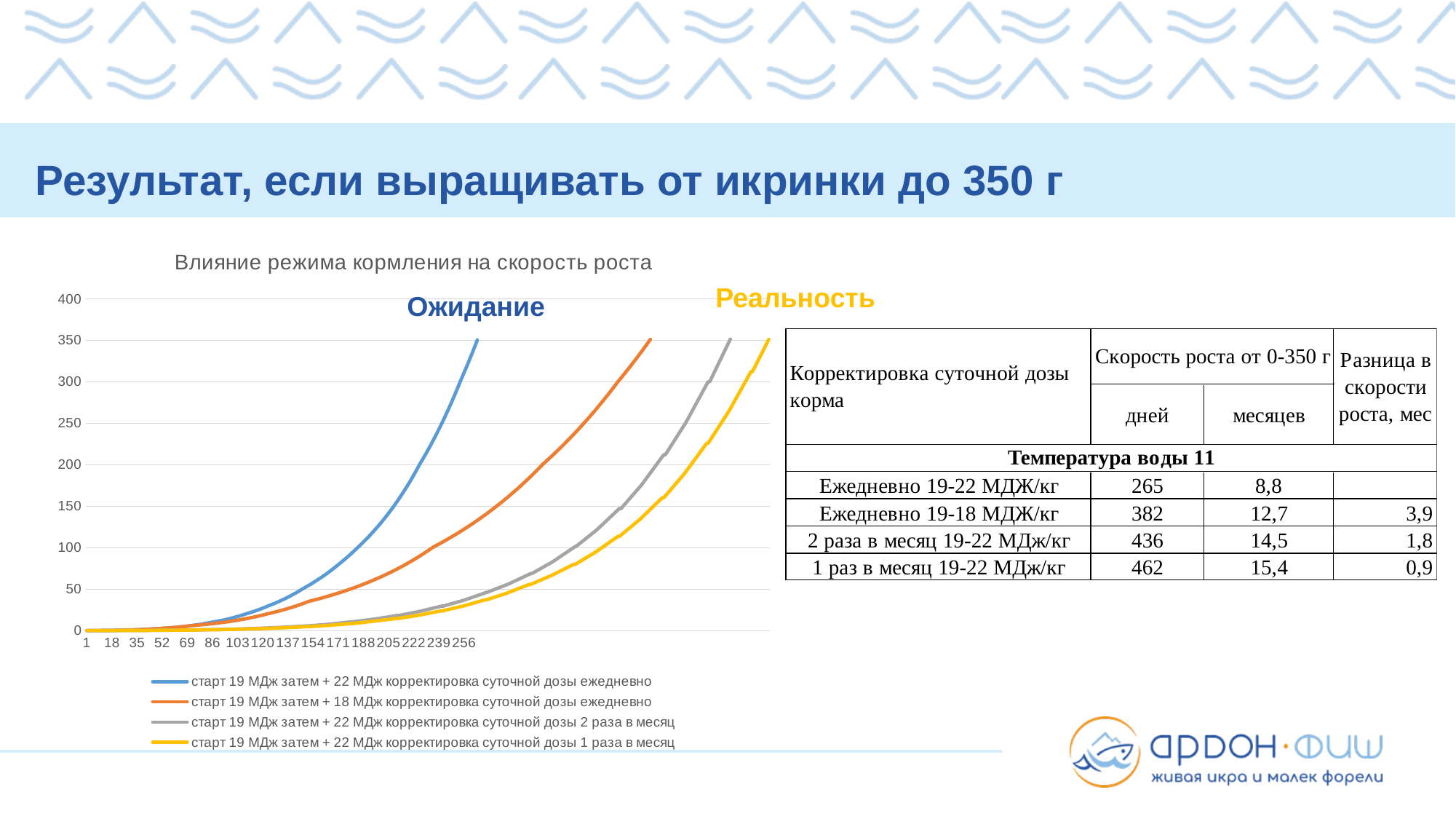
How many tick labels are shown on the x axis of the chart? 16 At x = 103, is the value of the blue series (ежедневно + 22 МДж) greater or less than 100? less What kind of chart is shown on the slide? line chart How many series does the chart legend list? 4 At x = 256, is the value of the orange series (ежедневно + 18 МДж) greater or less than 200? less What colour is the line for the series 'старт 19 МДж затем + 22 МДж корректировка суточной дозы 1 раза в месяц'? yellow Which series reaches 350 first (at the smallest x value)? старт 19 МДж затем + 22 МДж корректировка суточной дозы ежедневно What is the title of the chart? Влияние режима кормления на скорость роста Which series is the last to reach 350 (at the largest x value)? старт 19 МДж затем + 22 МДж корректировка суточной дозы 1 раза в месяц At x = 256, which series has the higher value: the blue series (ежедневно + 22 МДж) or the orange series (ежедневно + 18 МДж)? the blue series (ежедневно + 22 МДж) At x = 256, is the value of the yellow series (1 раза в месяц) greater or less than 100? less Do the plotted values rise or fall as you move along the x axis? rise